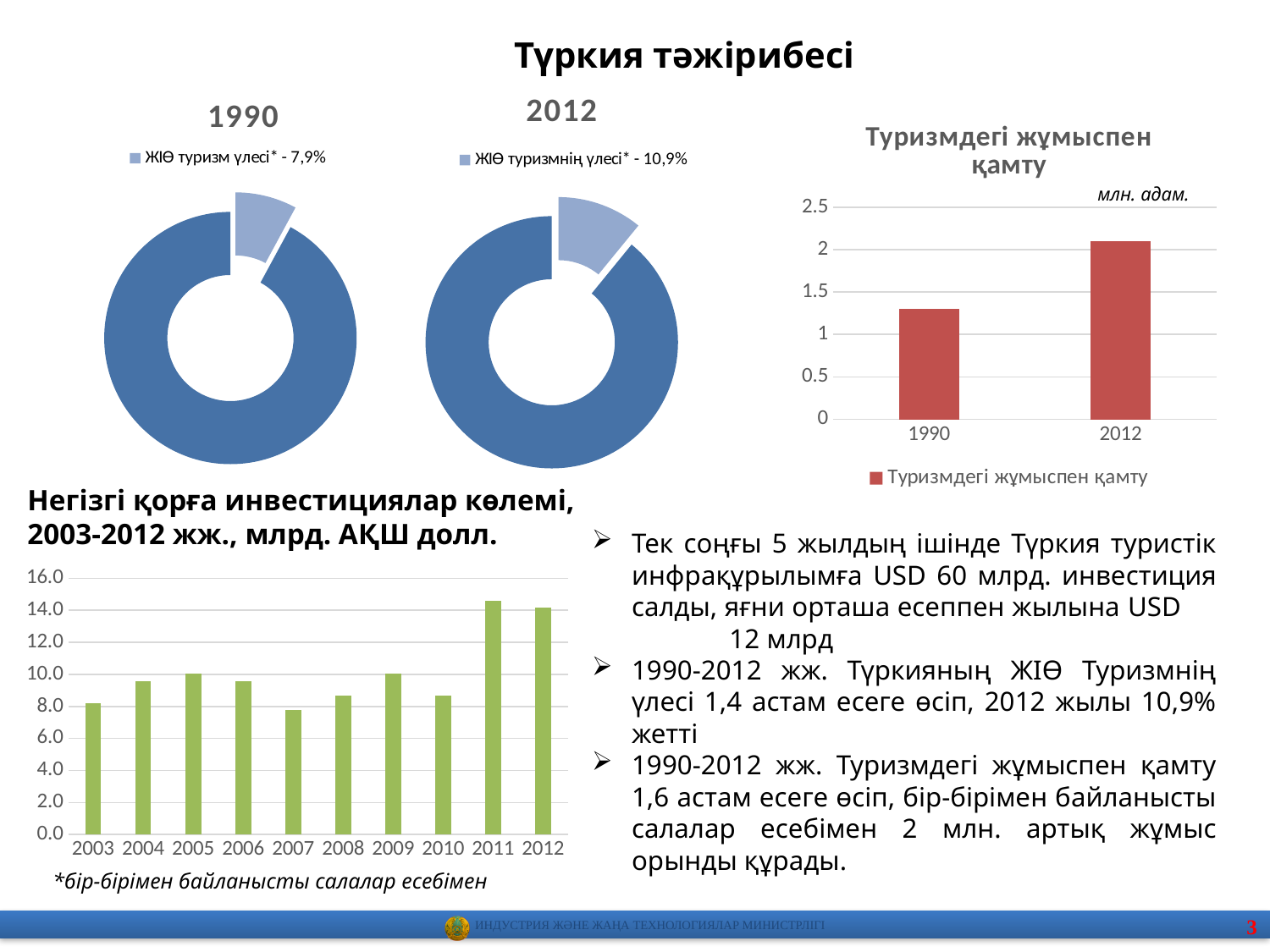
In the chart titled 'Туризмдегі жұмыспен қамту', is the value for 2012 greater or less than 2? greater In the chart titled 'Туризмдегі жұмыспен қамту', what unit is indicated above the axis? млн. адам. In the chart titled 'Туризмдегі жұмыспен қамту', what kind of chart is shown? bar chart In the chart titled 'Негізгі қорға инвестициялар көлемі, 2003-2012 жж., млрд. АҚШ долл.', which year has the lowest value? 2007 In the 1990 donut chart, what share of GDP does tourism account for, according to the legend? 7,9% In the chart titled 'Туризмдегі жұмыспен қамту', how many categories are plotted? 2 Comparing the 1990 and 2012 donut charts, in which year is the tourism share of GDP larger? 2012 In the chart titled 'Негізгі қорға инвестициялар көлемі, 2003-2012 жж., млрд. АҚШ долл.', is the value for 2007 greater or less than 8.0? less In the 2012 donut chart, what share of GDP does tourism account for, according to the legend? 10,9% In the chart titled 'Негізгі қорға инвестициялар көлемі, 2003-2012 жж., млрд. АҚШ долл.', how many years are plotted? 10 In the chart titled 'Туризмдегі жұмыспен қамту', is the value for 1990 greater or less than 1.5? less In the chart titled 'Негізгі қорға инвестициялар көлемі, 2003-2012 жж., млрд. АҚШ долл.', which year has the highest value? 2011